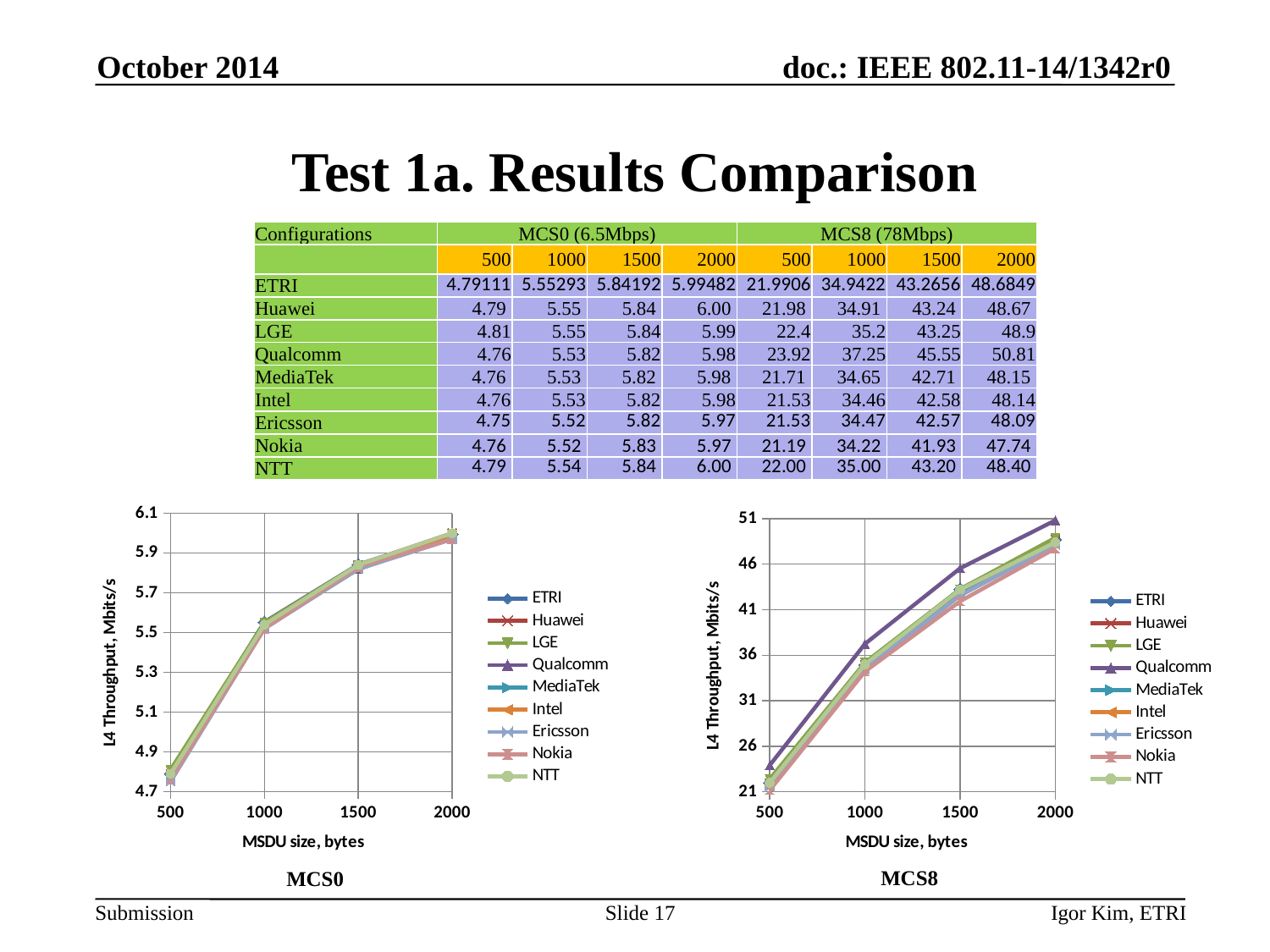
What kind of chart is the MCS8 chart on the right? line chart In the MCS0 chart, is the value for Huawei at 2000 bytes greater or less than 5.9? greater How many series does the legend of the MCS0 chart list? 9 In the MCS8 chart, is the value for Qualcomm at 1500 bytes greater or less than 41? greater What is the y-axis title of the MCS8 chart? L4 Throughput, Mbits/s In the MCS8 chart, is the value for Nokia at 500 bytes greater or less than 26? less In the MCS8 chart, which is larger at 1000 bytes, the value for Qualcomm or the value for Nokia? Qualcomm In the MCS0 chart, do the throughput values rise or fall as MSDU size increases from 500 to 2000 bytes? rise In the MCS8 chart, which series has the highest throughput at an MSDU size of 2000 bytes? Qualcomm How many MSDU size points are plotted along the x axis of the MCS8 chart? 4 What is the x-axis title of the MCS0 chart? MSDU size, bytes